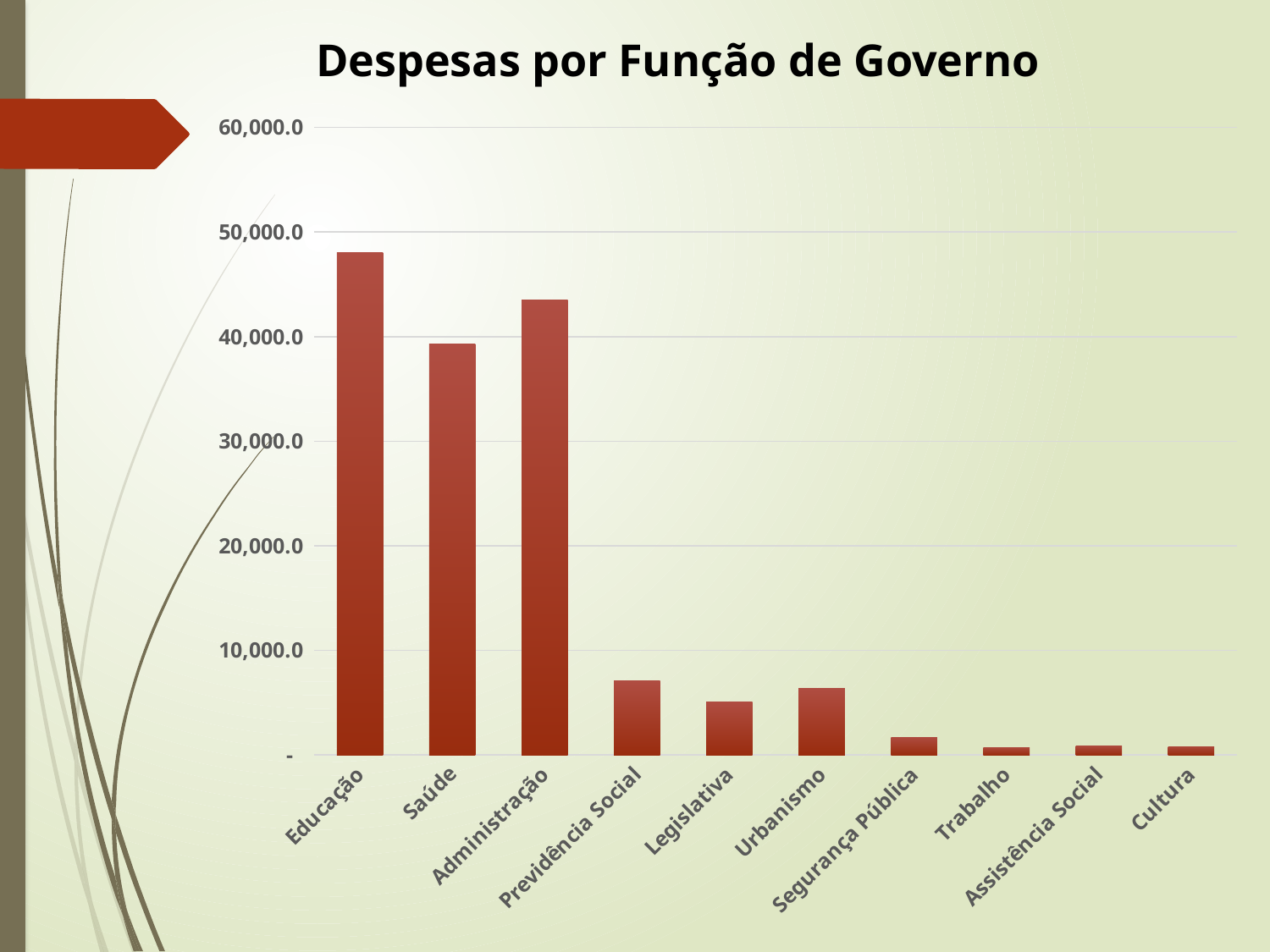
Which is larger, the value for Educação or the value for Saúde? Educação Is the value for Administração greater or less than 40,000.0? greater Do the values generally rise or fall from left to right along the x axis? fall How many categories are shown on the x axis of the chart? 10 Which is larger, the value for Administração or the value for Saúde? Administração Which category has the highest value in the chart? Educação What is the title of the chart? Despesas por Função de Governo Is the value for Previdência Social greater or less than 10,000.0? less What kind of chart is shown on the slide? bar chart Which is larger, the value for Previdência Social or the value for Legislativa? Previdência Social Is the value for Educação greater or less than 40,000.0? greater